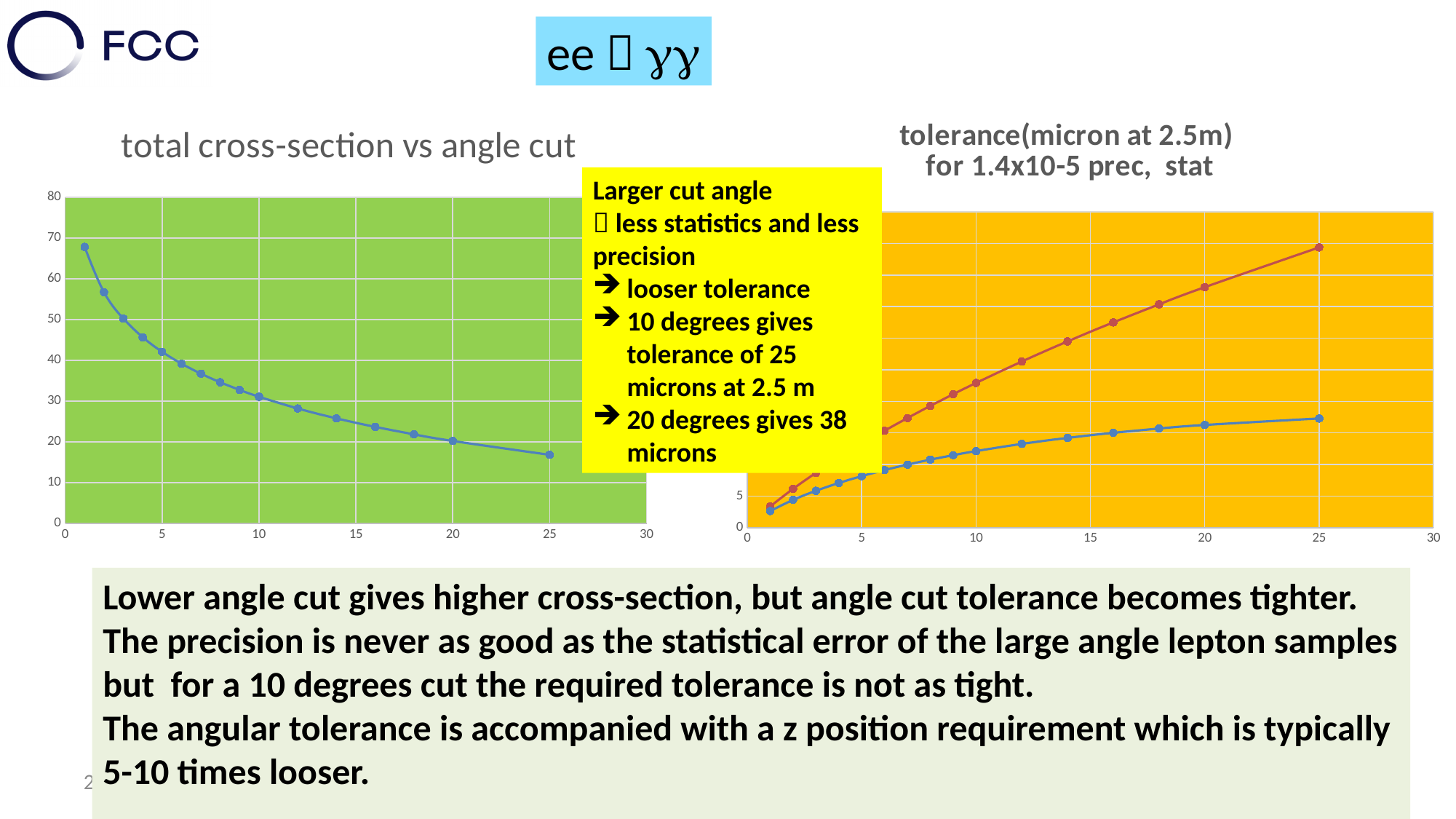
In the 'total cross-section vs angle cut' chart, is the value at x = 1 greater or less than 60? greater What kind of chart is the 'total cross-section vs angle cut' chart? line chart In the 'tolerance(micron at 2.5m)' chart on the right, which line is higher at x = 25, the red line or the blue line? red line How many lines are plotted in the 'tolerance(micron at 2.5m)' chart on the right? 2 What kind of chart is the 'tolerance(micron at 2.5m)' chart on the right? line chart In the 'total cross-section vs angle cut' chart, do the values rise or fall as the angle cut increases along the x axis? fall In the 'tolerance(micron at 2.5m)' chart on the right, do the plotted values rise or fall as x increases? rise In the 'total cross-section vs angle cut' chart, is the value at x = 25 greater or less than 20? less What is the title of the chart on the left of the slide? total cross-section vs angle cut In the 'total cross-section vs angle cut' chart, is the value at x = 12 greater or less than 30? less How many data points are plotted in the 'total cross-section vs angle cut' chart? 16